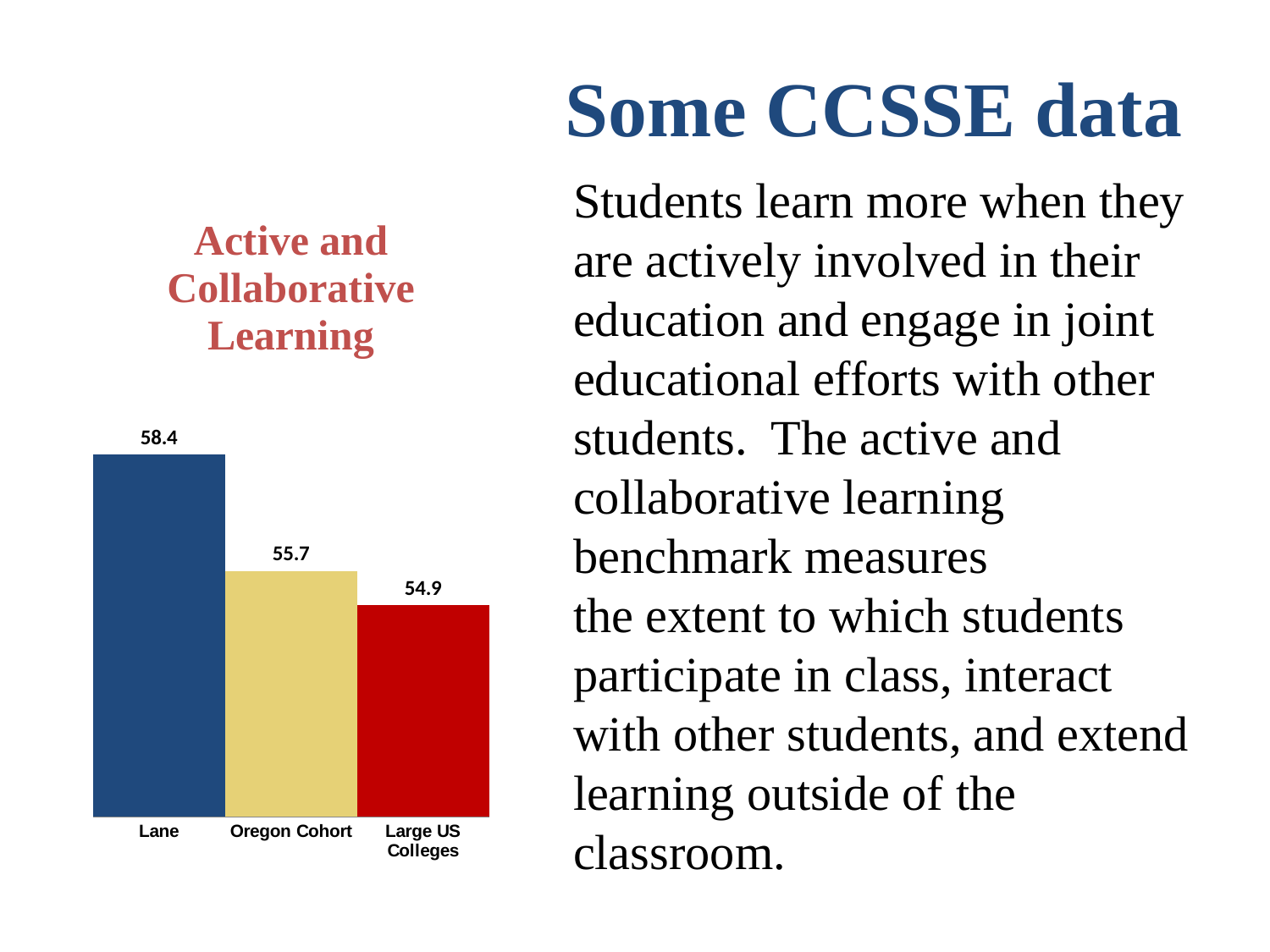
What is the value for Large US Colleges? 54.9 What is the difference between the values for Lane and Large US Colleges? 3.5 Which is larger, the value for Oregon Cohort or the value for Large US Colleges? Oregon Cohort What is the title of the chart? Active and Collaborative Learning Do the values rise or fall from left to right across the categories? Fall What is the value for Lane? 58.4 What kind of chart is shown on the slide? Bar chart How many categories are shown in the chart? 3 What is the value for Oregon Cohort? 55.7 What is the difference between the values for Lane and Oregon Cohort? 2.7 Which category has the highest value? Lane Which category has the lowest value? Large US Colleges